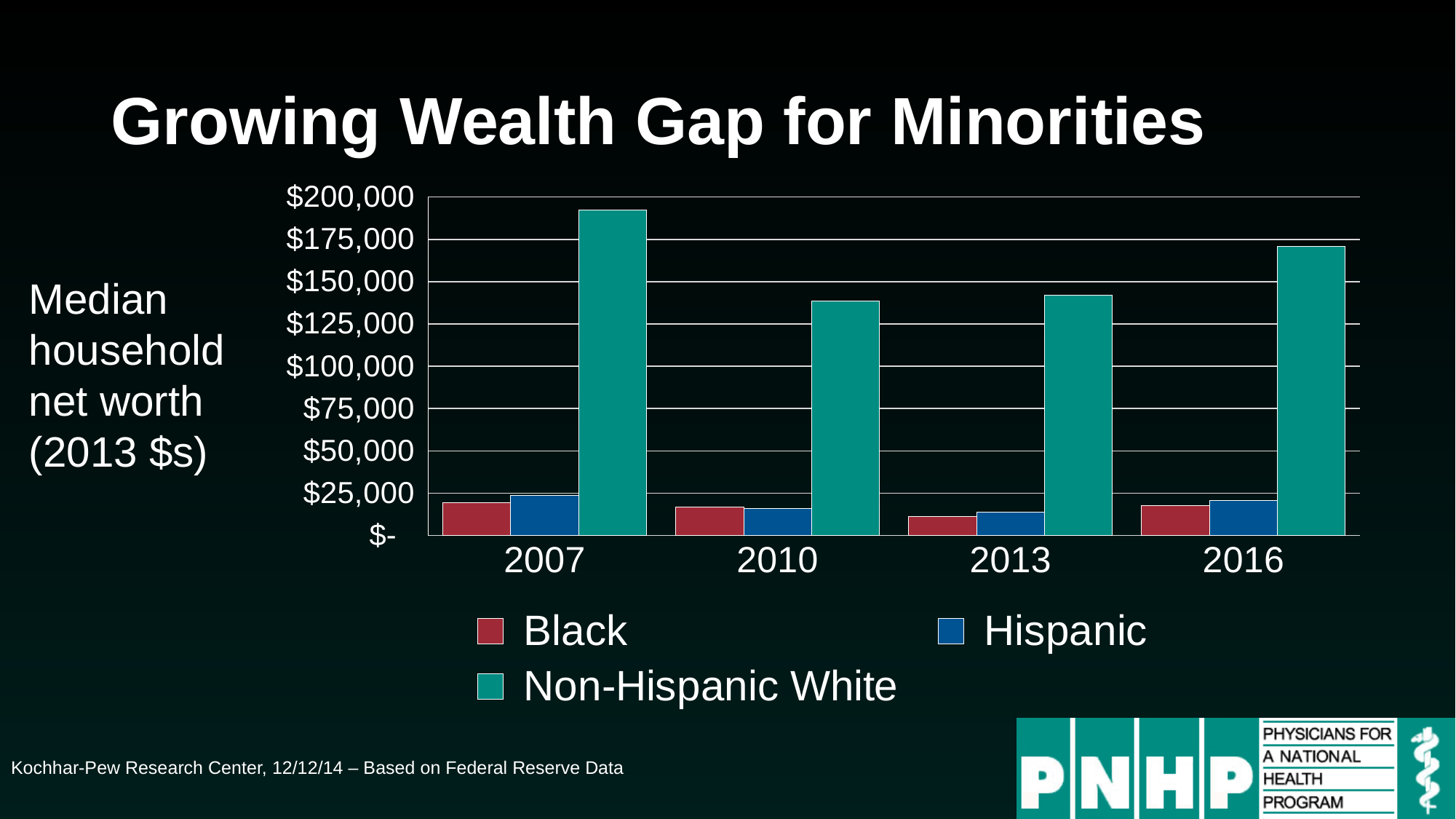
Is the Non-Hispanic White value for 2007 greater or less than $175,000? greater What kind of chart is shown on the slide? bar chart Does the Non-Hispanic White median household net worth rise or fall from 2007 to 2010? fall In which year is the Black median household net worth lowest? 2013 Is the Non-Hispanic White value for 2010 greater or less than $150,000? less In which year is the Non-Hispanic White median household net worth highest? 2007 What quantity does the chart plot, according to the label to the left of the chart? Median household net worth (2013 $s) How many series does the legend list? 3 In 2007, which is larger: the Black value or the Hispanic value? Hispanic Which series is shown in teal in the legend? Non-Hispanic White How many years are shown on the x axis? 4 Is the Black value for 2007 greater or less than $25,000? less